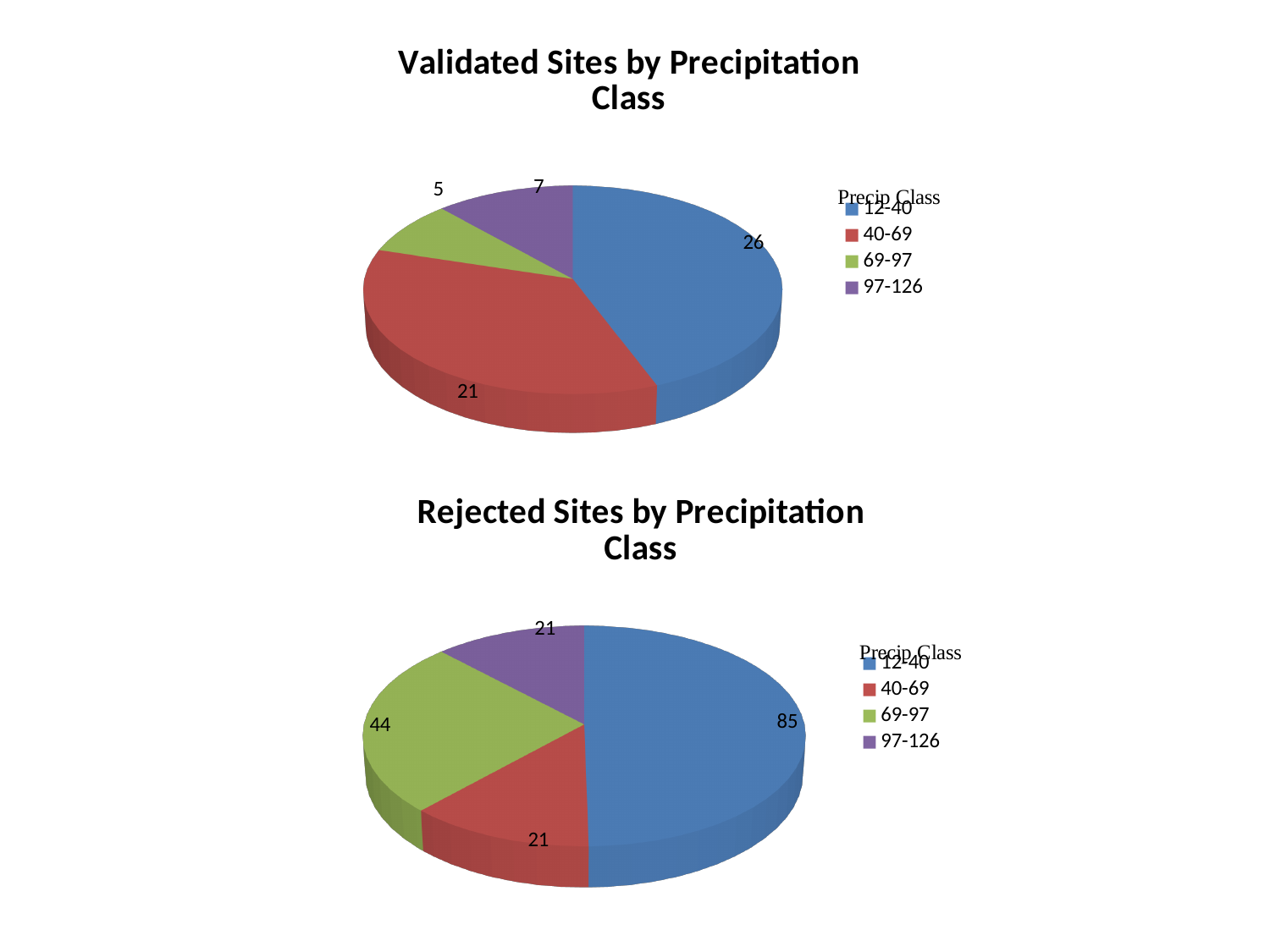
In the 'Rejected Sites by Precipitation Class' chart, what is the value for the 12-40 class? 85 In the 'Validated Sites by Precipitation Class' chart, what is the difference between the 12-40 class and the 40-69 class? 5 In the 'Validated Sites by Precipitation Class' chart, what is the value for the 69-97 class? 5 How many precipitation classes are shown in the 'Validated Sites by Precipitation Class' chart? 4 In the 'Rejected Sites by Precipitation Class' chart, which precipitation class has the largest slice? 12-40 In the 'Rejected Sites by Precipitation Class' chart, what is the value for the 69-97 class? 44 In the 'Validated Sites by Precipitation Class' chart, which precipitation class has the largest slice? 12-40 In the 'Rejected Sites by Precipitation Class' chart, what is the difference between the 12-40 class and the 69-97 class? 41 In the 'Rejected Sites by Precipitation Class' chart, which is larger, the 40-69 class or the 69-97 class? 69-97 In the 'Validated Sites by Precipitation Class' chart, what is the value for the 12-40 class? 26 In the 'Validated Sites by Precipitation Class' chart, which precipitation class has the smallest slice? 69-97 What type of chart is the 'Rejected Sites by Precipitation Class' chart? Pie chart